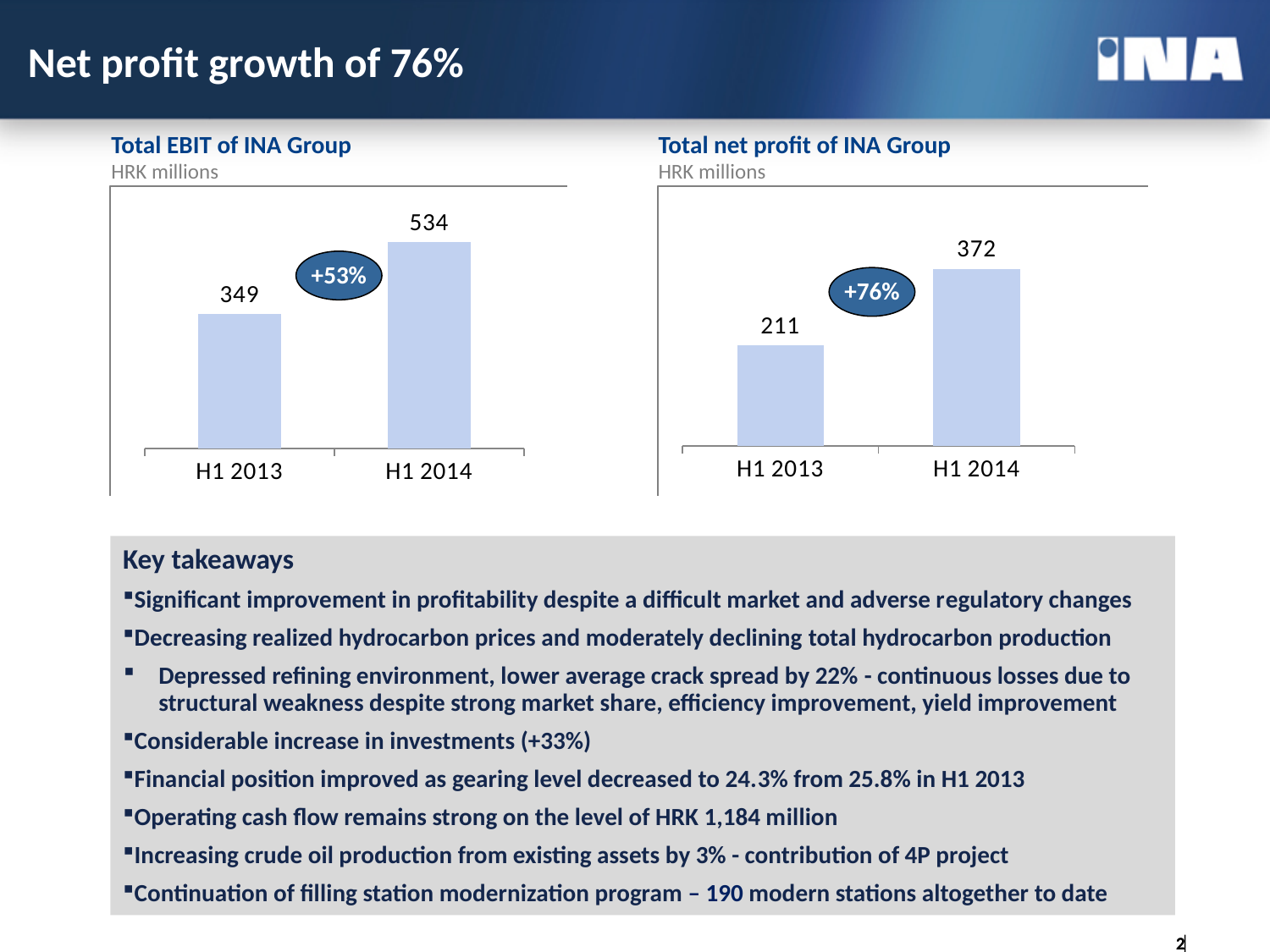
In the 'Total EBIT of INA Group' chart, what is the difference between the H1 2014 and H1 2013 values? 185 In the 'Total net profit of INA Group' chart, is the value for H1 2014 larger or smaller than the value for H1 2013? larger In the 'Total EBIT of INA Group' chart, which period has the higher value? H1 2014 What type of chart is the 'Total net profit of INA Group' chart? bar chart In the 'Total net profit of INA Group' chart, what is the value for H1 2013? 211 What percentage change is shown in the oval label on the 'Total EBIT of INA Group' chart? +53% In the 'Total net profit of INA Group' chart, what is the value for H1 2014? 372 In the 'Total net profit of INA Group' chart, which period has the lowest value? H1 2013 In the 'Total EBIT of INA Group' chart, what is the value for H1 2013? 349 How many bars are shown in the 'Total EBIT of INA Group' chart? 2 In the 'Total EBIT of INA Group' chart, what is the value for H1 2014? 534 In the 'Total net profit of INA Group' chart, what is the difference between the H1 2014 and H1 2013 values? 161